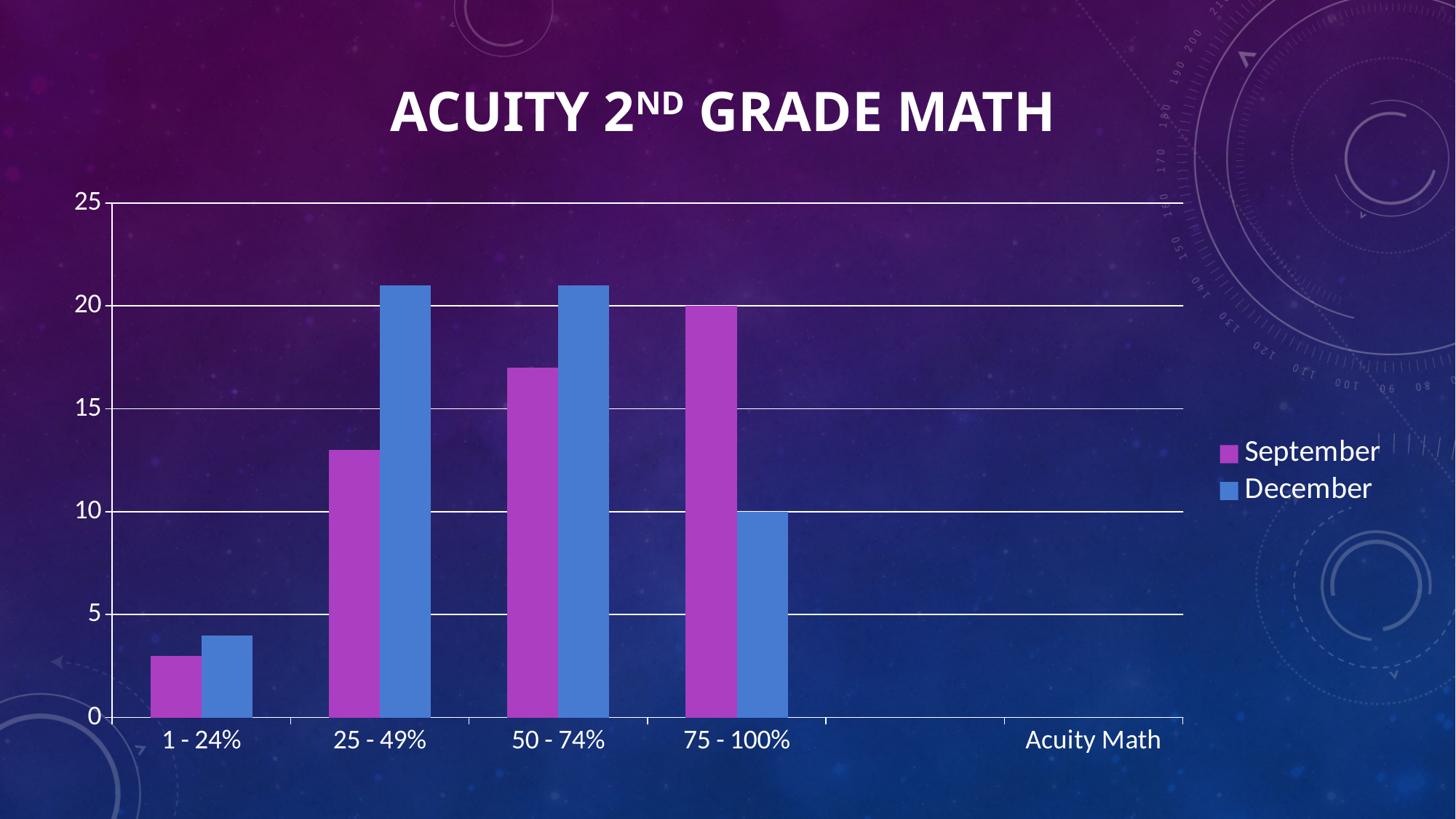
What is the December value for the 75 - 100% category? 10 Is the September value for the 1 - 24% category greater or less than 5? less For the 50 - 74% category, which is larger, the September value or the December value? December Which category has the highest September value? 75 - 100% What kind of chart is shown on the slide? bar chart Do the September values rise or fall from the 1 - 24% category to the 75 - 100% category? rise What is the September value for the 75 - 100% category? 20 Is the December value for the 25 - 49% category greater or less than 20? greater What is the difference between the September and December values for the 75 - 100% category? 10 What is the title of the chart? Acuity 2nd Grade Math How many series does the legend list? 2 Which category has the lowest December value? 1 - 24%